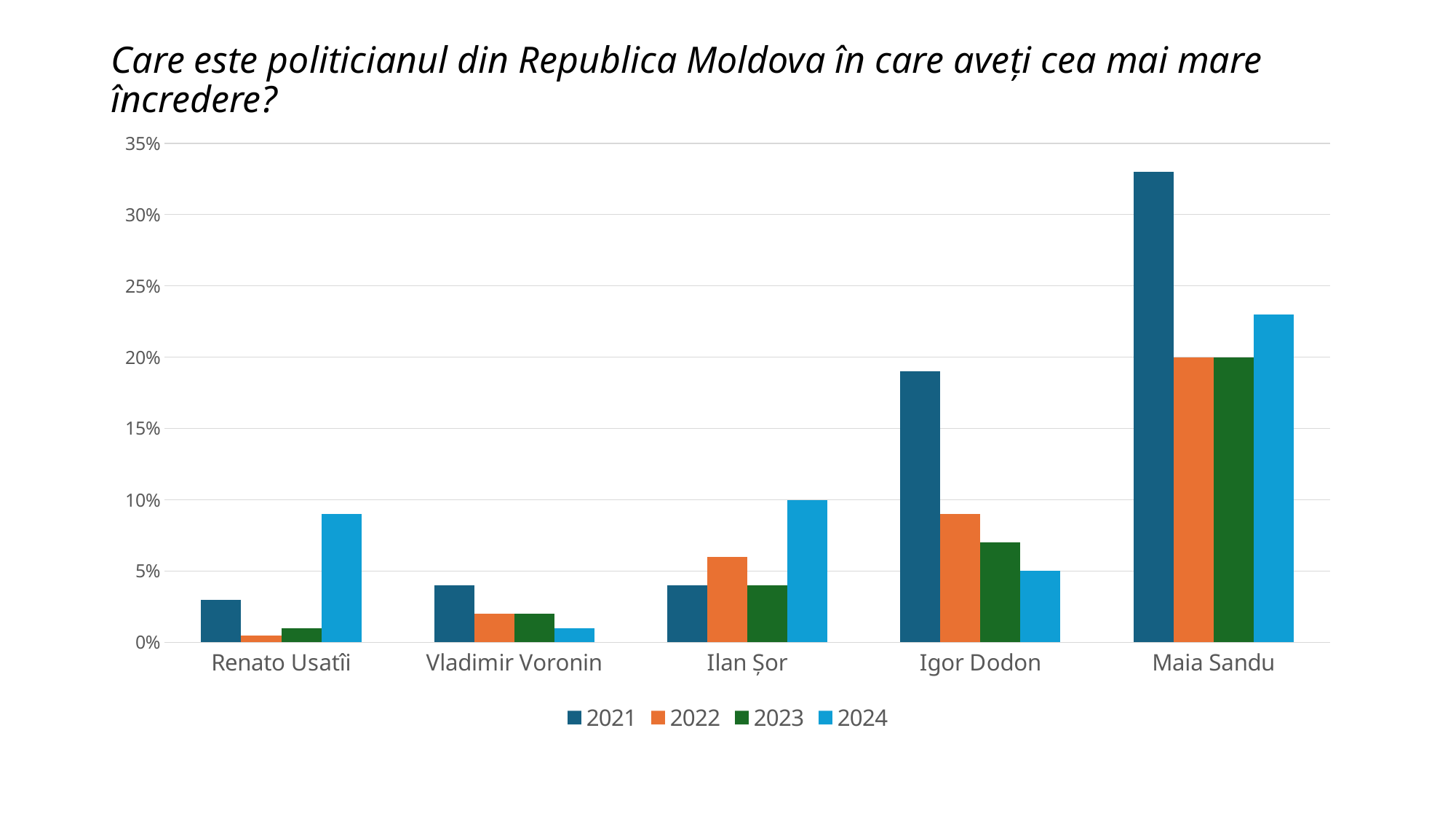
Which politician has the lowest value for 2022? Renato Usatîi What is the value for Maia Sandu in 2022? 20% Is the value for Maia Sandu in 2021 greater or less than 30%? greater Which is larger for Igor Dodon: the 2021 value or the 2024 value? 2021 Which politician has the highest value for 2021? Maia Sandu What is the value for Ilan Șor in 2024? 10% Which series is shown in orange in the legend? 2022 How many politicians are shown on the x axis? 5 How many series does the legend list? 4 Is the value for Igor Dodon in 2021 greater or less than 20%? less What is the value for Igor Dodon in 2024? 5% What kind of chart is shown on the slide? bar chart